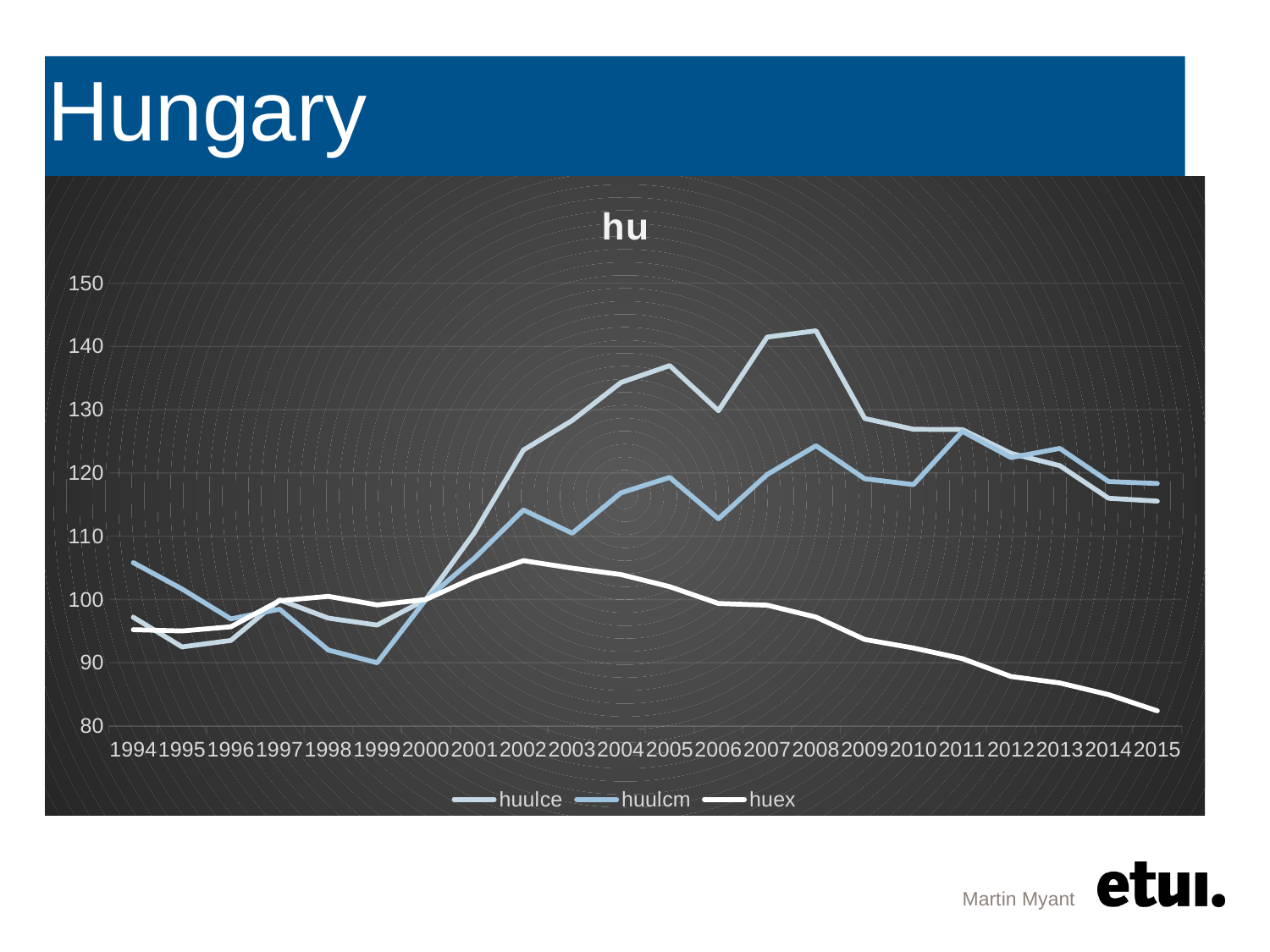
How many series does the legend list? 3 Is the value for huulcm in 1999 greater or less than 100? less Is the value for huulce in 2005 greater or less than 130? greater Is the value for huex in 2015 greater or less than 90? less What kind of chart is shown on the slide? line chart In 2010, which is larger, huulce or huex? huulce Which series has the lowest value in 2015? huex Does the huex series rise or fall from 2002 to 2015? fall How many years are plotted along the x axis? 22 Which series has the highest value in 2008? huulce Which series are listed in the legend? huulce, huulcm, huex What is the title of the chart? hu